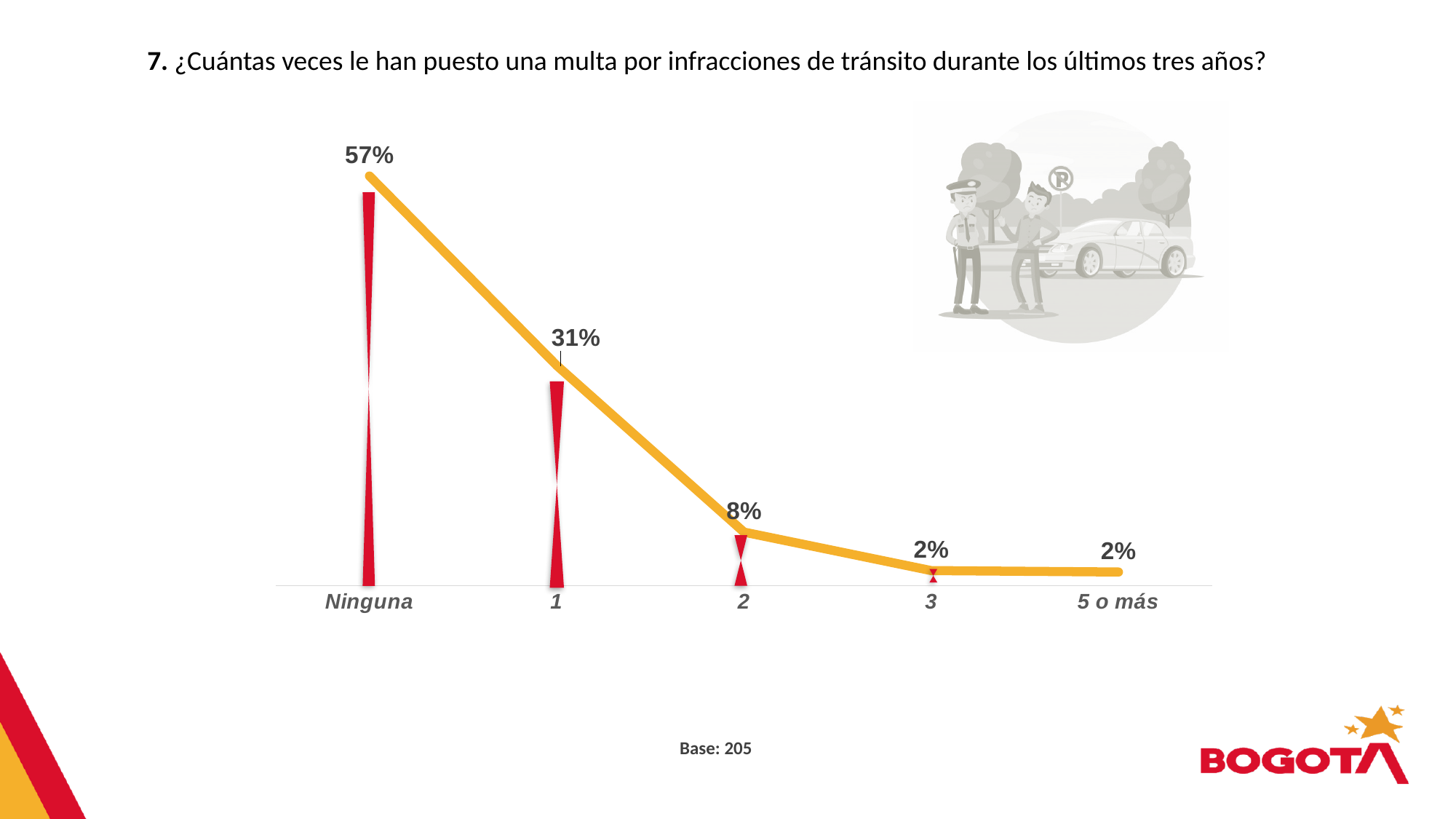
How many categories are shown on the x axis? 5 What is the value shown for the category "3"? 2% What is the value shown for the category "2"? 8% Do the values rise or fall moving from left to right along the x axis? fall What percentage of respondents answered "Ninguna"? 57% Which category has the highest value? Ninguna What is the difference in percentage points between "1" and "2"? 23 What is the value shown for the category "5 o más"? 2% What is the difference in percentage points between "Ninguna" and "1"? 26 What is the value shown for the category "1"? 31% Which is larger, the value for "2" or the value for "3"? 2 What base (number of respondents) is stated below the chart? 205